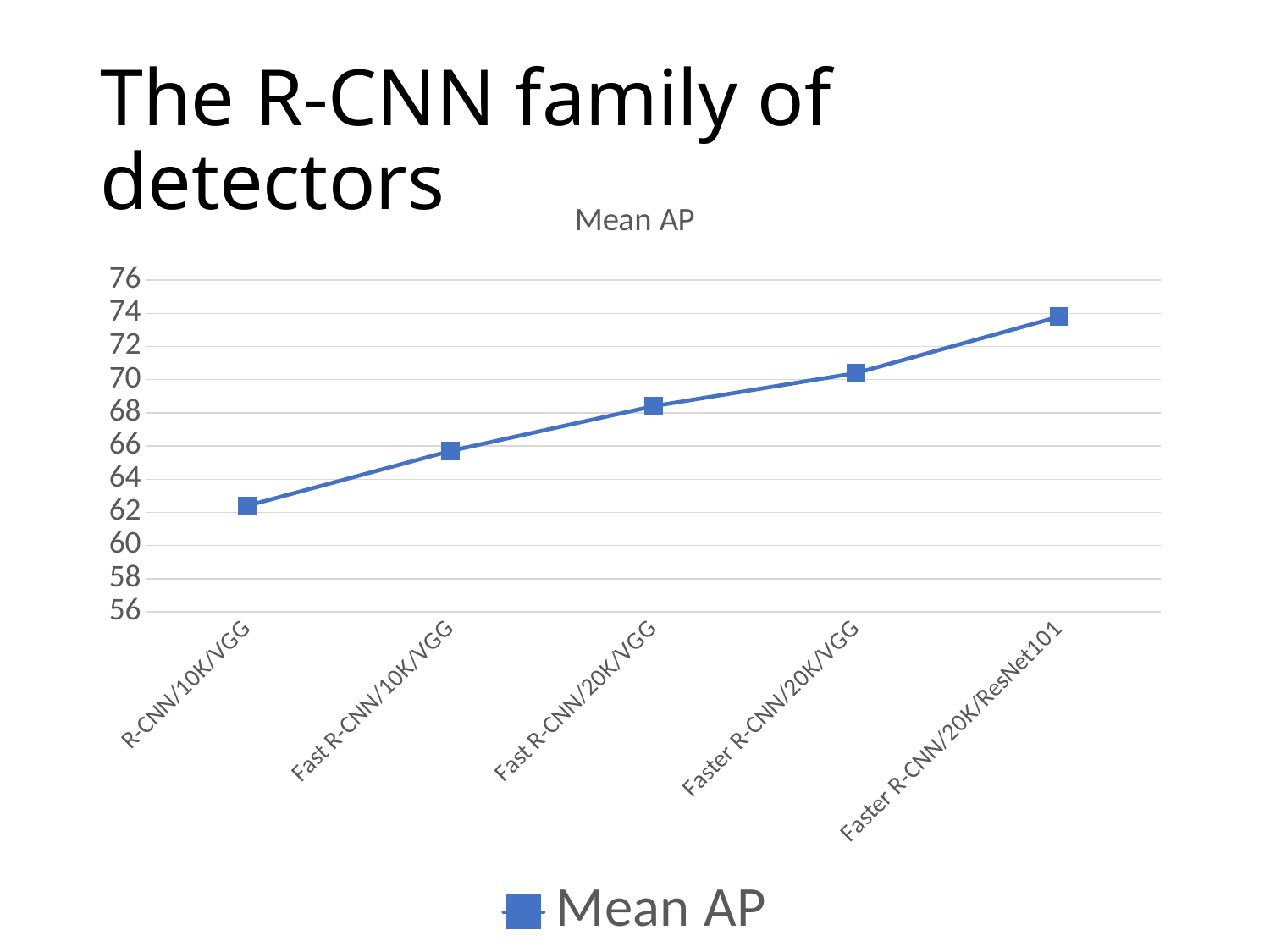
Is the Mean AP for Fast R-CNN/10K/VGG greater or less than 64? greater How many series does the legend list? 1 Does the Mean AP rise or fall from left to right along the x axis? rise How many detector configurations are plotted along the x axis? 5 What is the title of the chart? Mean AP Is the Mean AP for R-CNN/10K/VGG greater or less than 64? less Is the Mean AP for Faster R-CNN/20K/ResNet101 greater or less than 72? greater Which detector configuration has the lowest Mean AP? R-CNN/10K/VGG Which detector configuration has the highest Mean AP? Faster R-CNN/20K/ResNet101 Which has a higher Mean AP, Faster R-CNN/20K/VGG or Fast R-CNN/10K/VGG? Faster R-CNN/20K/VGG What kind of chart is shown on the slide? line chart